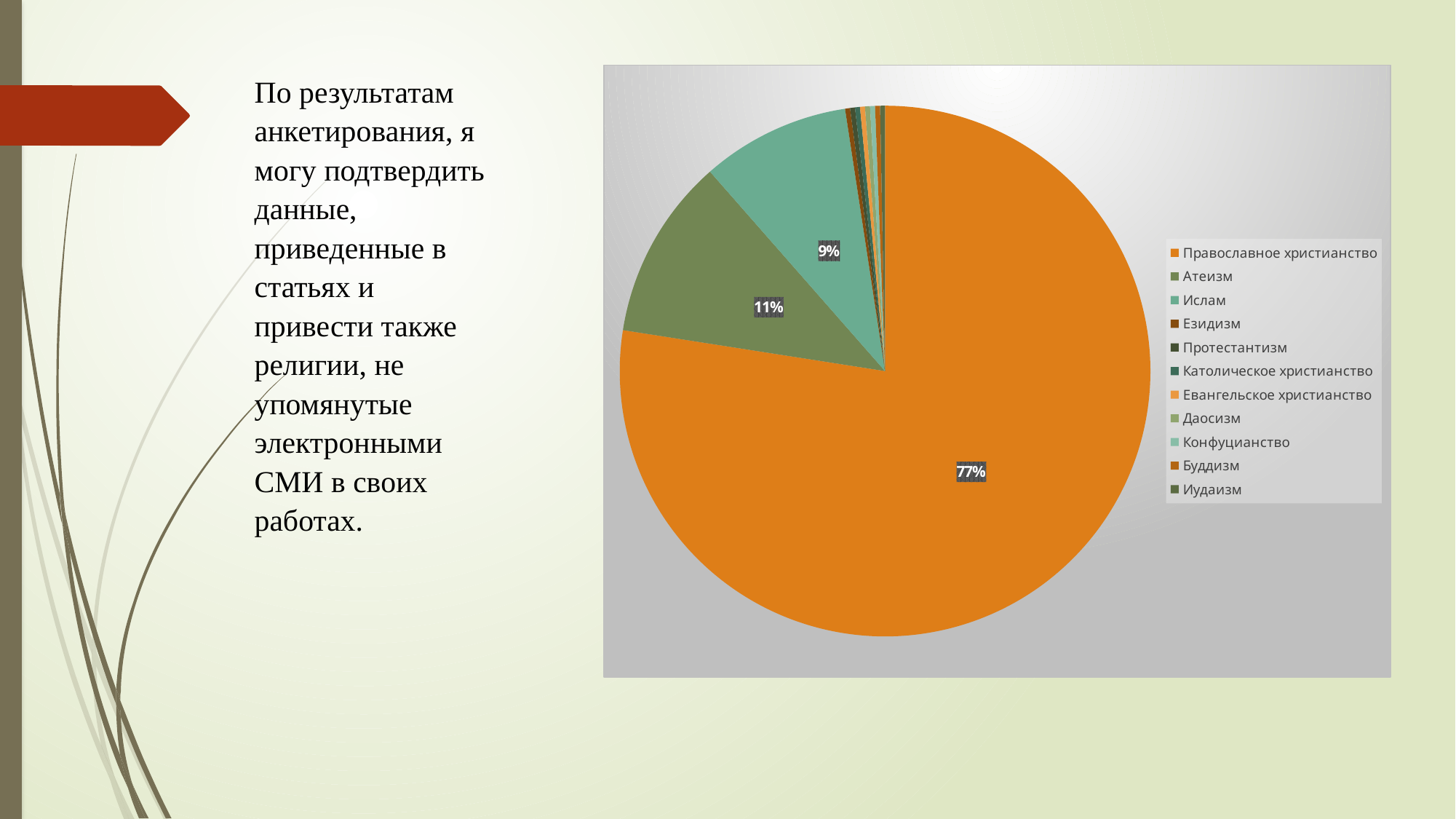
What percentage is shown for Атеизм in the pie chart? 11% What colour is the slice for Православное христианство? Orange How many categories are listed in the chart's legend? 11 What percentage of the pie chart does Православное христианство account for? 77% What share of the pie does the Ислам slice represent? 9% By how many percentage points does Православное христианство exceed Атеизм? 66 What type of chart is shown on the slide? Pie chart Which category has the largest slice in the pie chart? Православное христианство Which slice is larger, Православное христианство or Атеизм? Православное христианство What percentage is shown for Ислам in the pie chart? 9% Which slice is larger, Атеизм or Ислам? Атеизм By how many percentage points does Атеизм exceed Ислам? 2